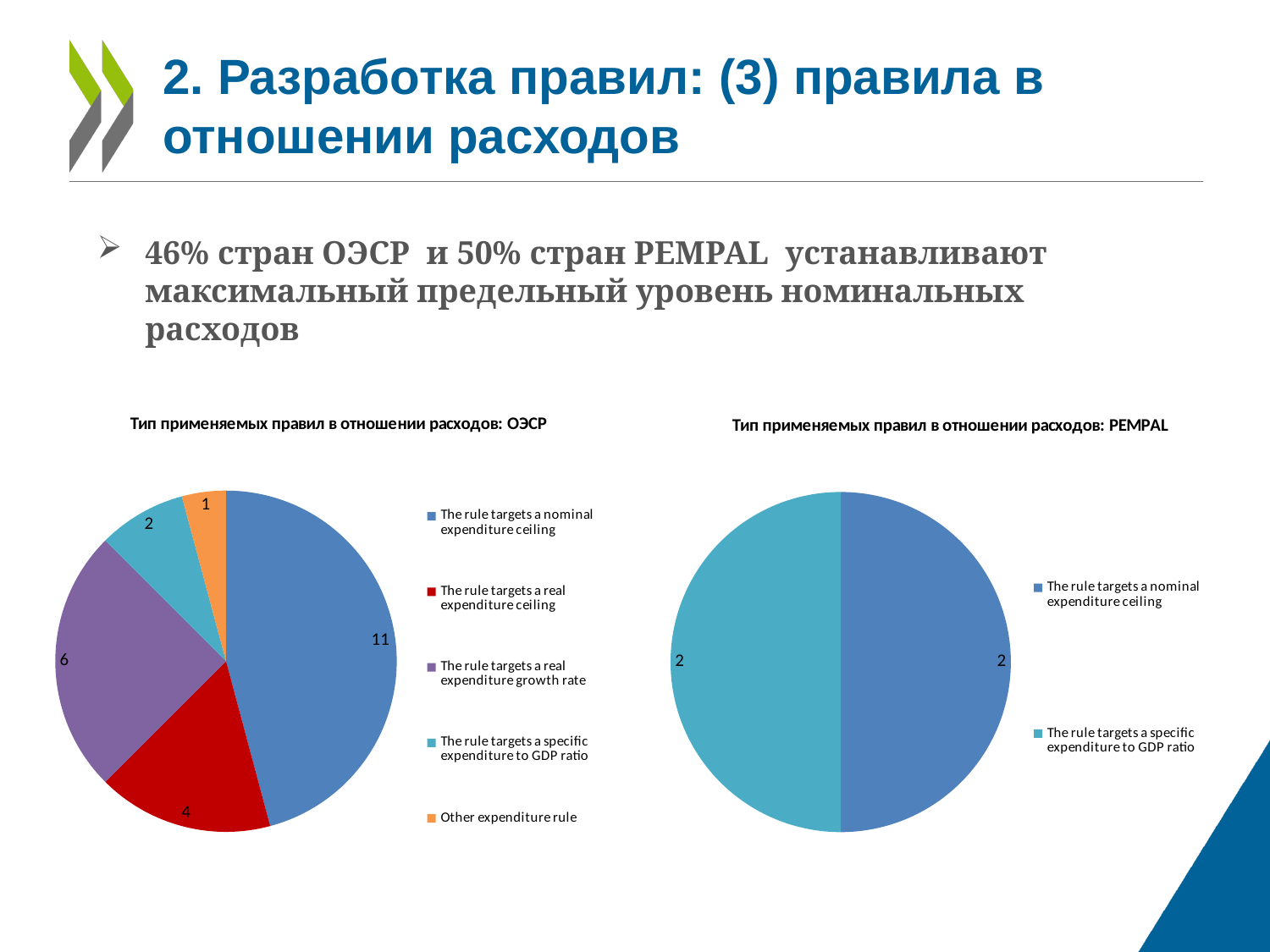
In the chart titled 'Тип применяемых правил в отношении расходов: ОЭСР', what is the total of all slices? 24 In the chart titled 'Тип применяемых правил в отношении расходов: ОЭСР', which category has the largest slice? The rule targets a nominal expenditure ceiling In the chart titled 'Тип применяемых правил в отношении расходов: ОЭСР', which is larger: 'The rule targets a real expenditure growth rate' or 'The rule targets a specific expenditure to GDP ratio'? The rule targets a real expenditure growth rate In the chart titled 'Тип применяемых правил в отношении расходов: PEMPAL', what is the value for 'The rule targets a specific expenditure to GDP ratio'? 2 What kind of chart is the chart titled 'Тип применяемых правил в отношении расходов: PEMPAL'? Pie chart In the chart titled 'Тип применяемых правил в отношении расходов: PEMPAL', what share of the pie does 'The rule targets a nominal expenditure ceiling' represent? 50% In the chart titled 'Тип применяемых правил в отношении расходов: ОЭСР', what is the value for 'The rule targets a real expenditure growth rate'? 6 In the chart titled 'Тип применяемых правил в отношении расходов: ОЭСР', what is the value for 'The rule targets a nominal expenditure ceiling'? 11 In the chart titled 'Тип применяемых правил в отношении расходов: ОЭСР', what is the difference between the values for 'The rule targets a nominal expenditure ceiling' and 'The rule targets a real expenditure ceiling'? 7 In the chart titled 'Тип применяемых правил в отношении расходов: ОЭСР', which category has the smallest slice? Other expenditure rule In the chart titled 'Тип применяемых правил в отношении расходов: ОЭСР', what is the value for 'Other expenditure rule'? 1 In the chart titled 'Тип применяемых правил в отношении расходов: ОЭСР', how many categories does the legend list? 5